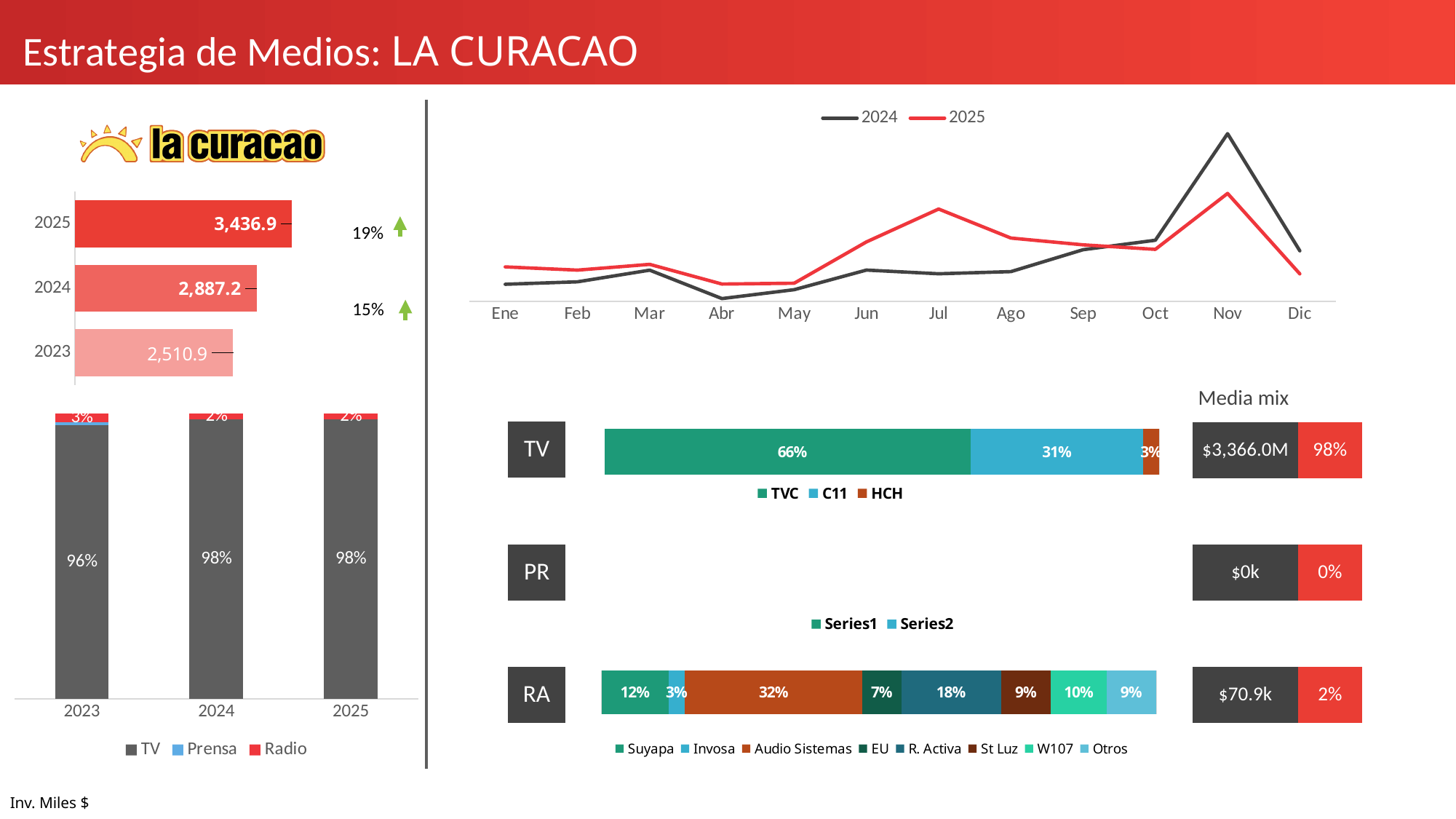
In the horizontal bar chart on the left, what is the difference between the 2025 and 2024 values? 549.7 In the RA stacked bar, what is the combined share of Suyapa and Invosa? 15% In the line chart at the top right, how many months are shown on the x axis? 12 In the line chart at the top right, in which month does the 2024 line reach its lowest point? Abr In the line chart at the top right, in which month does the 2024 line reach its highest point? Nov In the horizontal bar chart on the left, which year has the highest value? 2025 In the horizontal bar chart on the left, what is the value for 2023? 2,510.9 In the stacked bar chart at the bottom left, what share does TV have in 2023? 96% In the horizontal bar chart on the left, what is the value for 2025? 3,436.9 In the stacked bar chart at the bottom left, how many series does the legend list? 3 In the TV stacked bar, what share does TVC have? 66% In the RA stacked bar, which station has the largest share? Audio Sistemas